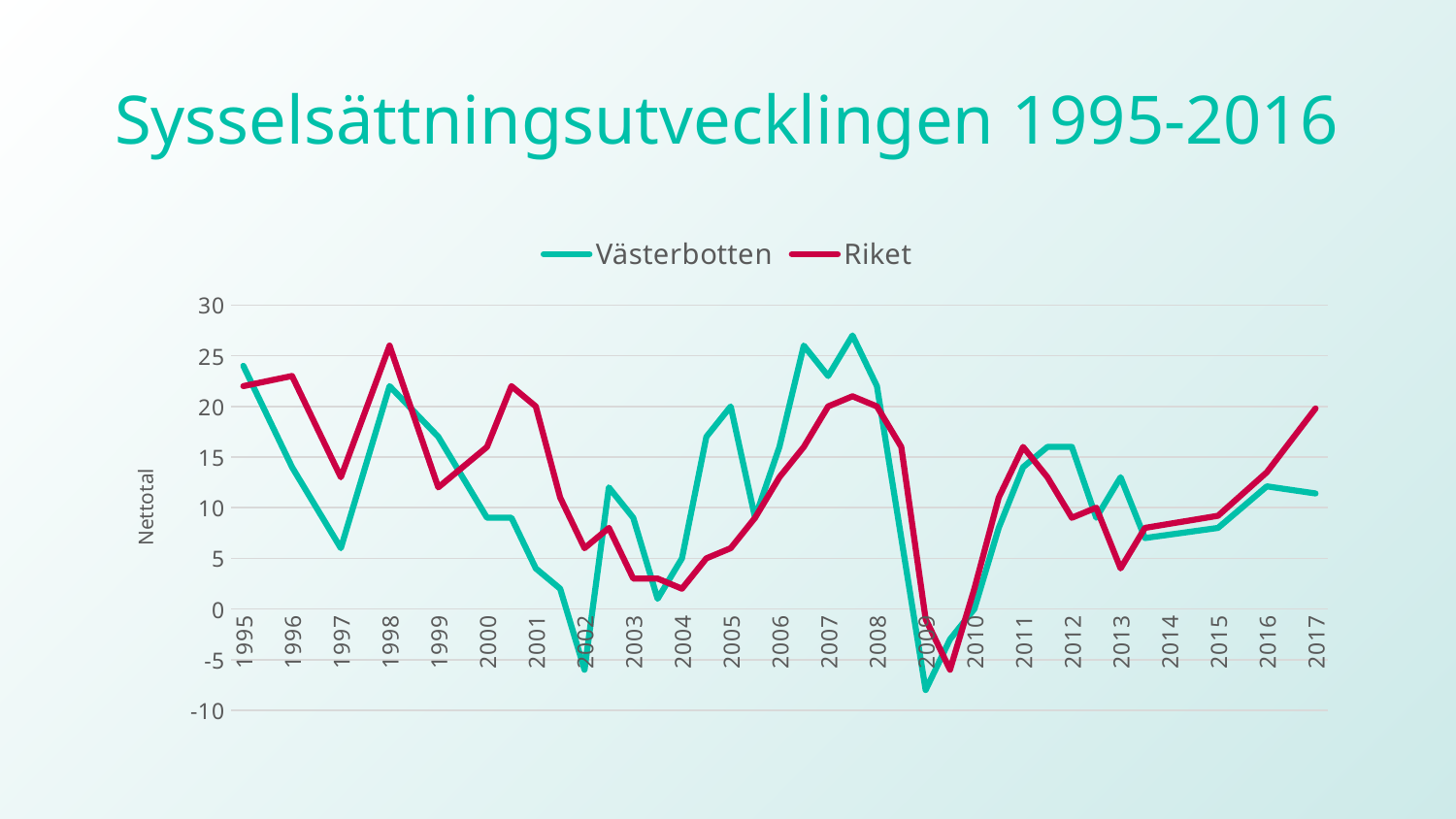
Does the Riket line rise or fall from 2013 to 2017? rise In which year does the Västerbotten line reach its lowest value? 2009 What kind of chart is shown on the slide? line chart How many years are labelled along the x axis? 23 Which two series are listed in the legend? Västerbotten and Riket In 2005, which series has the higher value, Västerbotten or Riket? Västerbotten Is the value for Riket in 1998 greater or less than 20? greater How many series does the legend list? 2 Is the value for Västerbotten in 2009 greater or less than -5? less Is the value for Västerbotten in 1997 greater or less than 10? less In which year does the Riket line reach its highest value? 1998 What is the label on the vertical axis? Nettotal